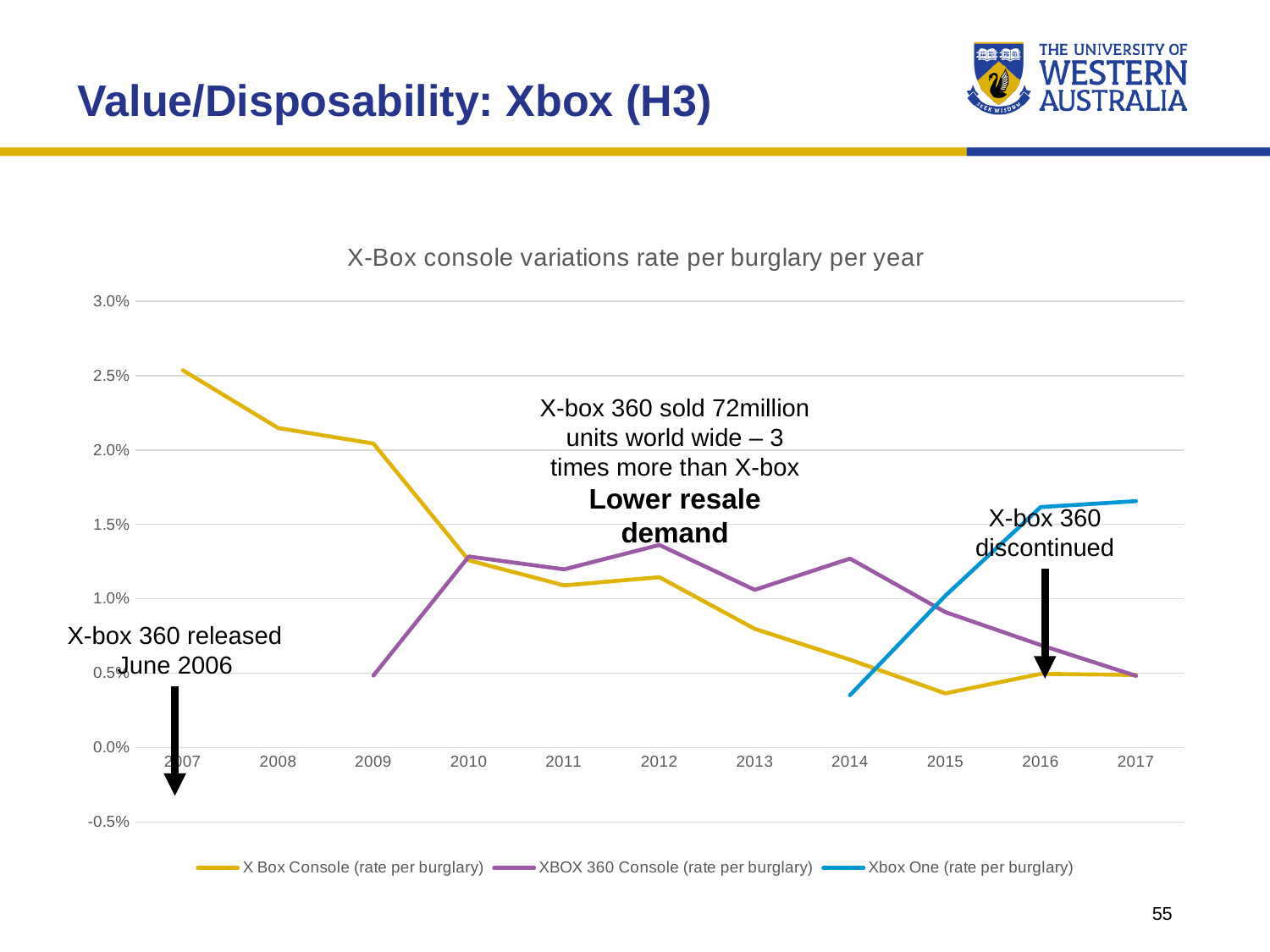
What is the title of the chart? X-Box console variations rate per burglary per year Is the value for XBOX 360 Console (rate per burglary) in 2012 greater or less than 1.0%? greater Does the Xbox One (rate per burglary) series rise or fall from 2014 to 2017? Rise How many years are shown on the x axis? 11 How many series does the legend list? 3 Does the X Box Console (rate per burglary) series generally rise or fall from 2007 to 2017? Fall Is the value for Xbox One (rate per burglary) in 2017 greater or less than 1.5%? greater What kind of chart is shown on the slide? Line chart Is the value for X Box Console (rate per burglary) in 2008 greater or less than 2.0%? greater In which year is the X Box Console (rate per burglary) series at its highest? 2007 In 2014, which series has the higher value: XBOX 360 Console (rate per burglary) or X Box Console (rate per burglary)? XBOX 360 Console (rate per burglary)